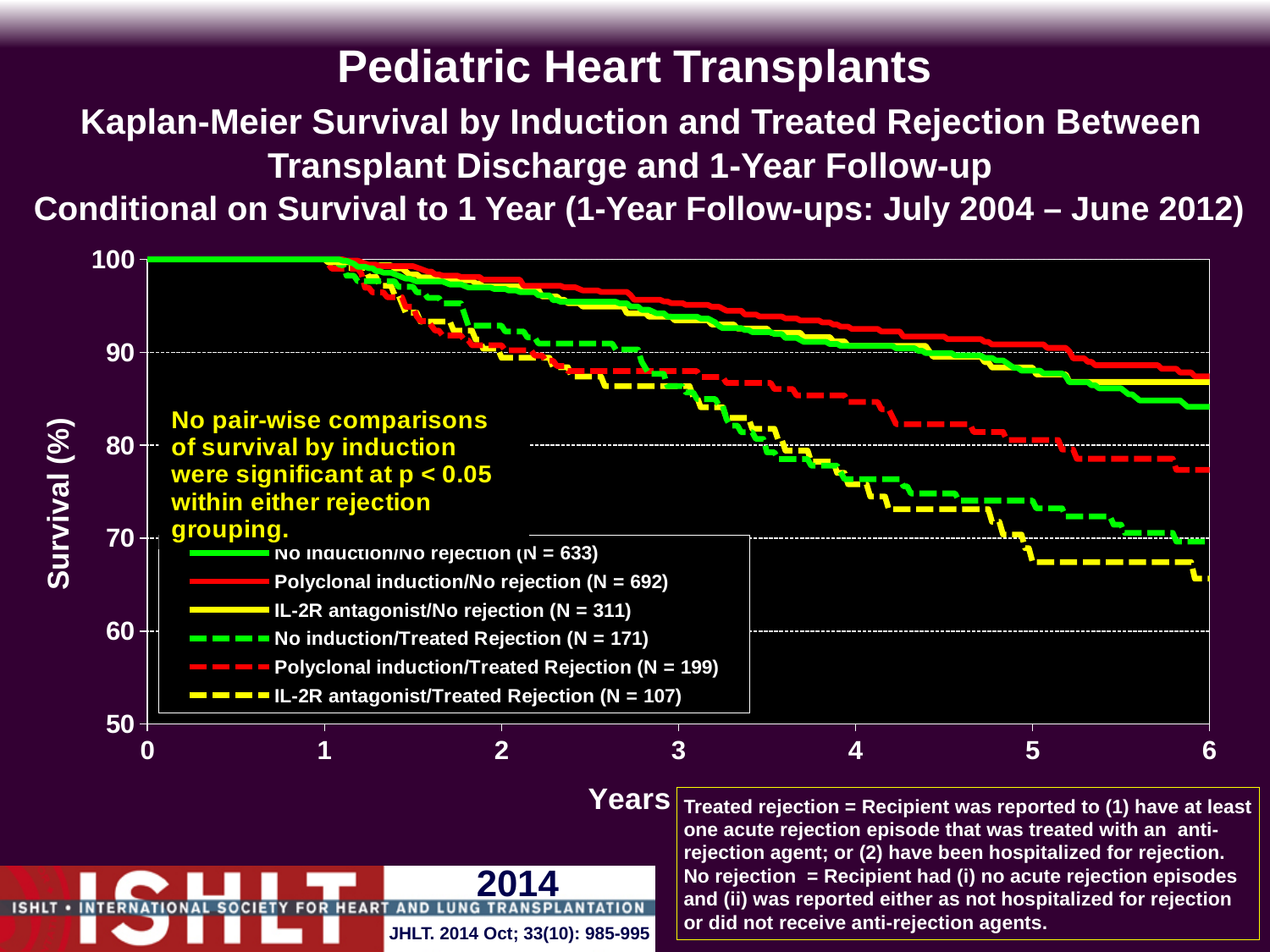
What kind of chart is shown on the slide? Line chart Which series has the lowest survival at 6 years? IL-2R antagonist/Treated Rejection At 6 years, which has higher survival: Polyclonal induction/No rejection or IL-2R antagonist/Treated Rejection? Polyclonal induction/No rejection At 6 years, is the survival value for Polyclonal induction/No rejection greater or less than 80? greater How many series does the legend list? 6 At 3 years, is the survival value for IL-2R antagonist/Treated Rejection greater or less than 80? greater According to the legend, what is the N for the Polyclonal induction/No rejection group? 692 Do the survival curves rise or fall as years increase along the x axis? Fall At 6 years, is the survival value for Polyclonal induction/Treated Rejection greater or less than 80? less What is the label of the y axis? Survival (%)